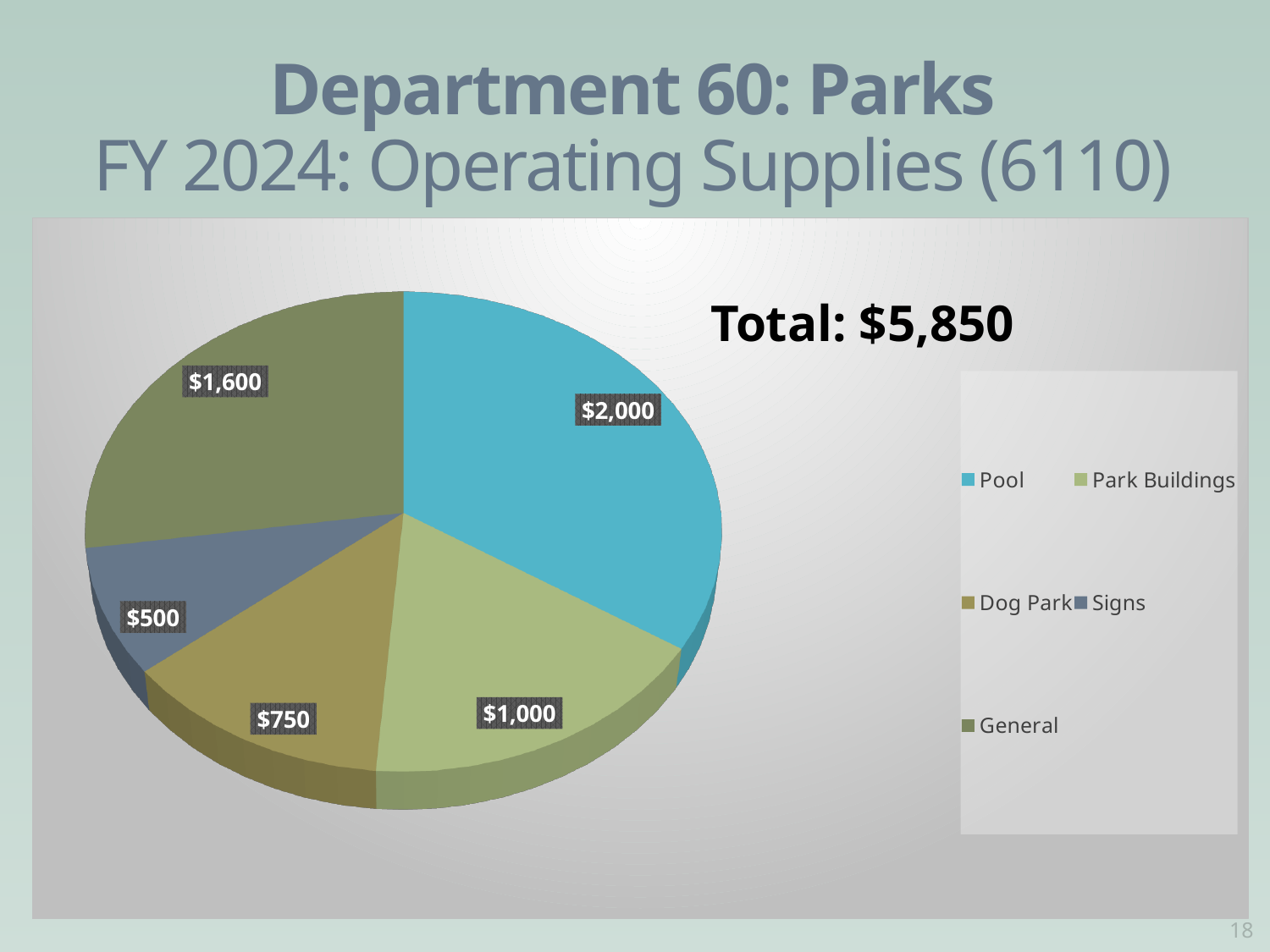
What total is stated on the slide for the chart? $5,850 What is the difference between the Pool and General values? $400 What type of chart is shown on the slide? Pie chart How many categories does the pie chart have? 5 What is the value for Signs? $500 What is the value for Pool? $2,000 What is the difference between the Park Buildings and Dog Park values? $250 Which category has the smallest slice? Signs Which is larger, Park Buildings or General? General What is the value for General? $1,600 What is the value for Dog Park? $750 Which category has the largest slice? Pool